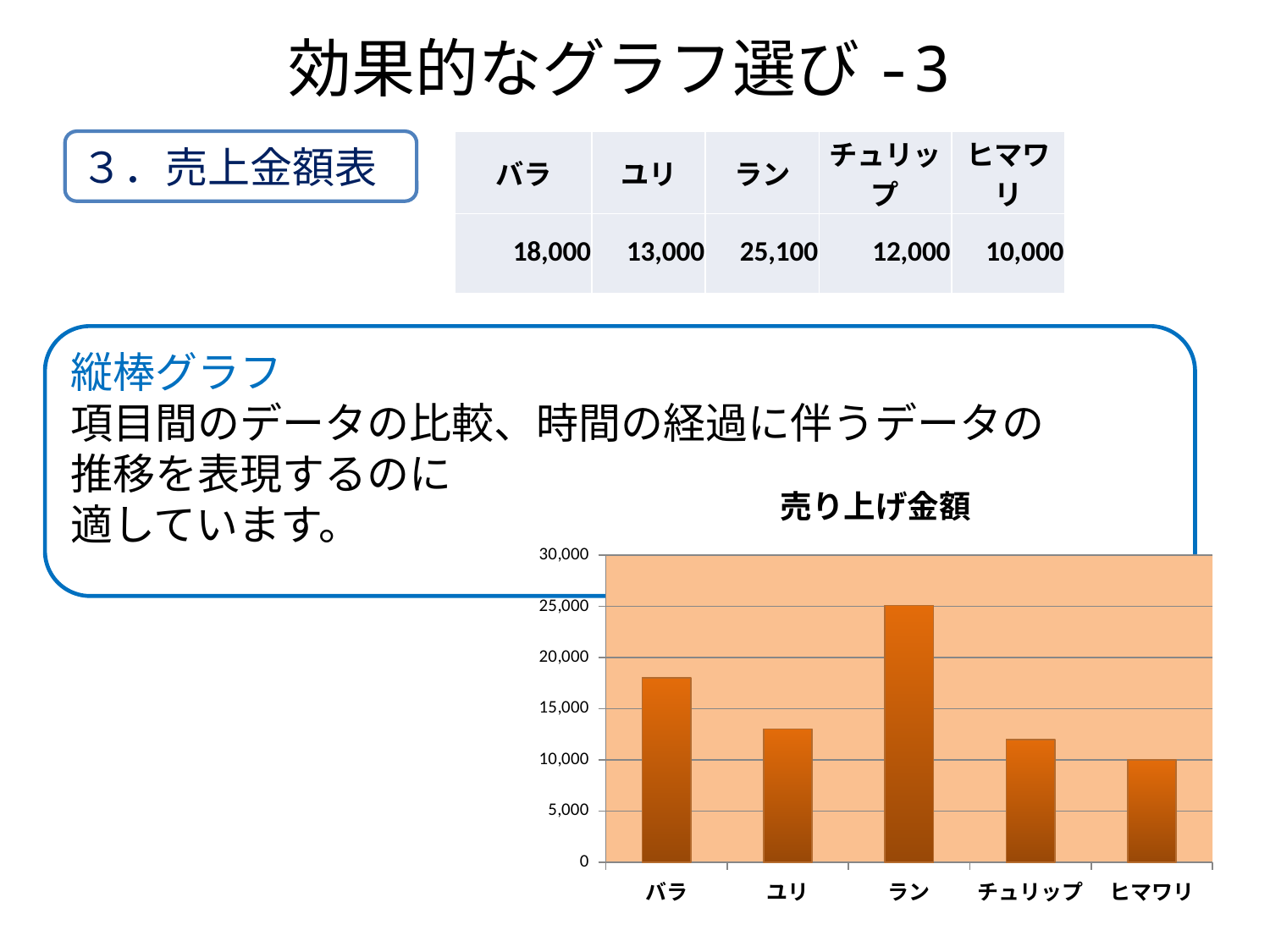
Which category has the highest value in the chart? ラン What is the title of the chart? 売り上げ金額 How many categories are plotted in the chart? 5 Is the value for バラ greater or less than 15,000? greater What is the value for ヒマワリ? 10,000 What is the value for バラ? 18,000 Is the value for チュリップ greater or less than 15,000? less What type of chart is shown on the slide? bar chart What is the difference between the value for ラン and the value for ヒマワリ? 15,100 What is the value for ラン? 25,100 Which is larger, the value for ユリ or the value for バラ? バラ Which category has the lowest value in the chart? ヒマワリ